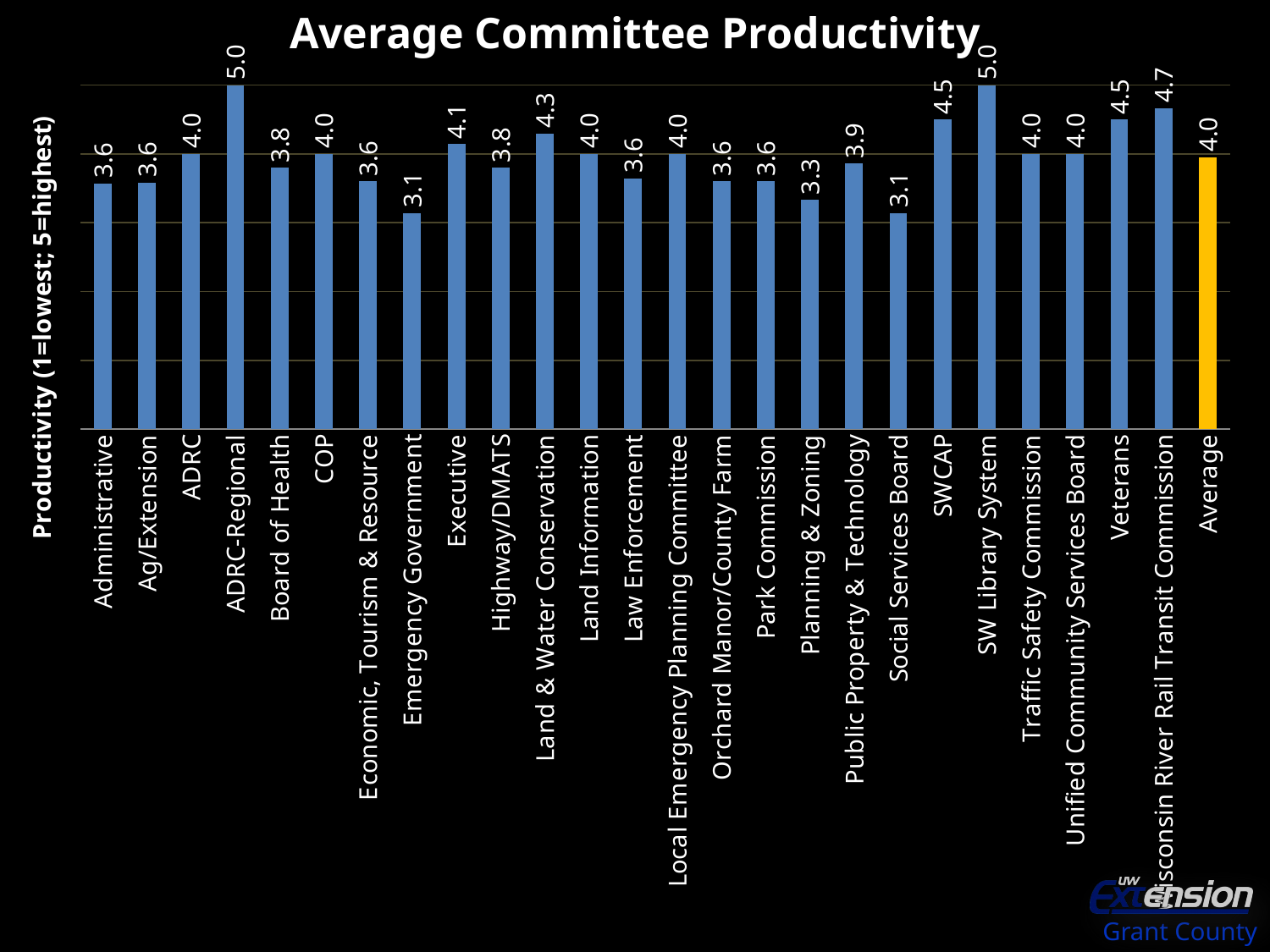
What is the highest productivity value shown on the chart? 5.0 How many bars are plotted on the chart, including the Average bar? 26 What is the difference between the values for Wisconsin River Rail Transit Commission and Planning & Zoning? 1.4 Which two committees share the lowest productivity value of 3.1? Emergency Government and Social Services Board Which has a higher productivity value, SWCAP or Executive? SWCAP What is the productivity value for Wisconsin River Rail Transit Commission? 4.7 What is the productivity value for Land & Water Conservation? 4.3 What is the value shown for the Average bar? 4.0 Which bar is coloured differently (yellow) from the rest? Average What is the productivity value for Public Property & Technology? 3.9 What kind of chart is shown on the slide? Bar chart What is the productivity value for Emergency Government? 3.1